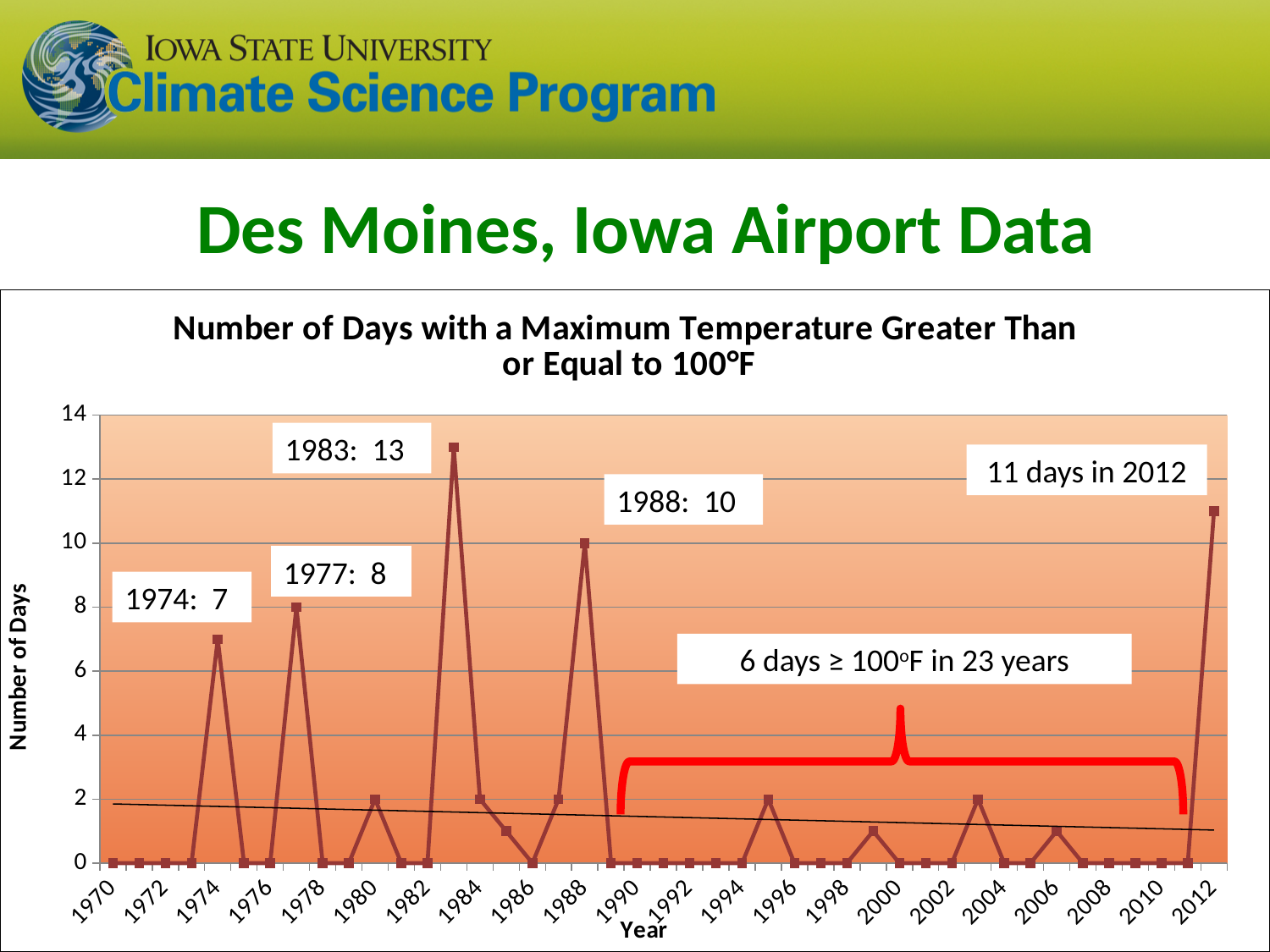
What is the label on the vertical axis of the chart? Number of Days Is the value for 1985 greater or less than 2? less How many days with a maximum temperature of at least 100°F were recorded in 1983? 13 Which year has the highest number of days with a maximum temperature of 100°F or more? 1983 What kind of chart is shown on the slide? Line chart How many days are shown for 2012? 11 What is the number of days plotted for 1988? 10 Which year had more days at or above 100°F, 1974 or 1977? 1977 What value is labeled for 1977? 8 What is the difference between the number of days in 1983 and in 1988? 3 What is the difference between the number of days in 2012 and in 1988? 1 What value is labeled for 1974? 7